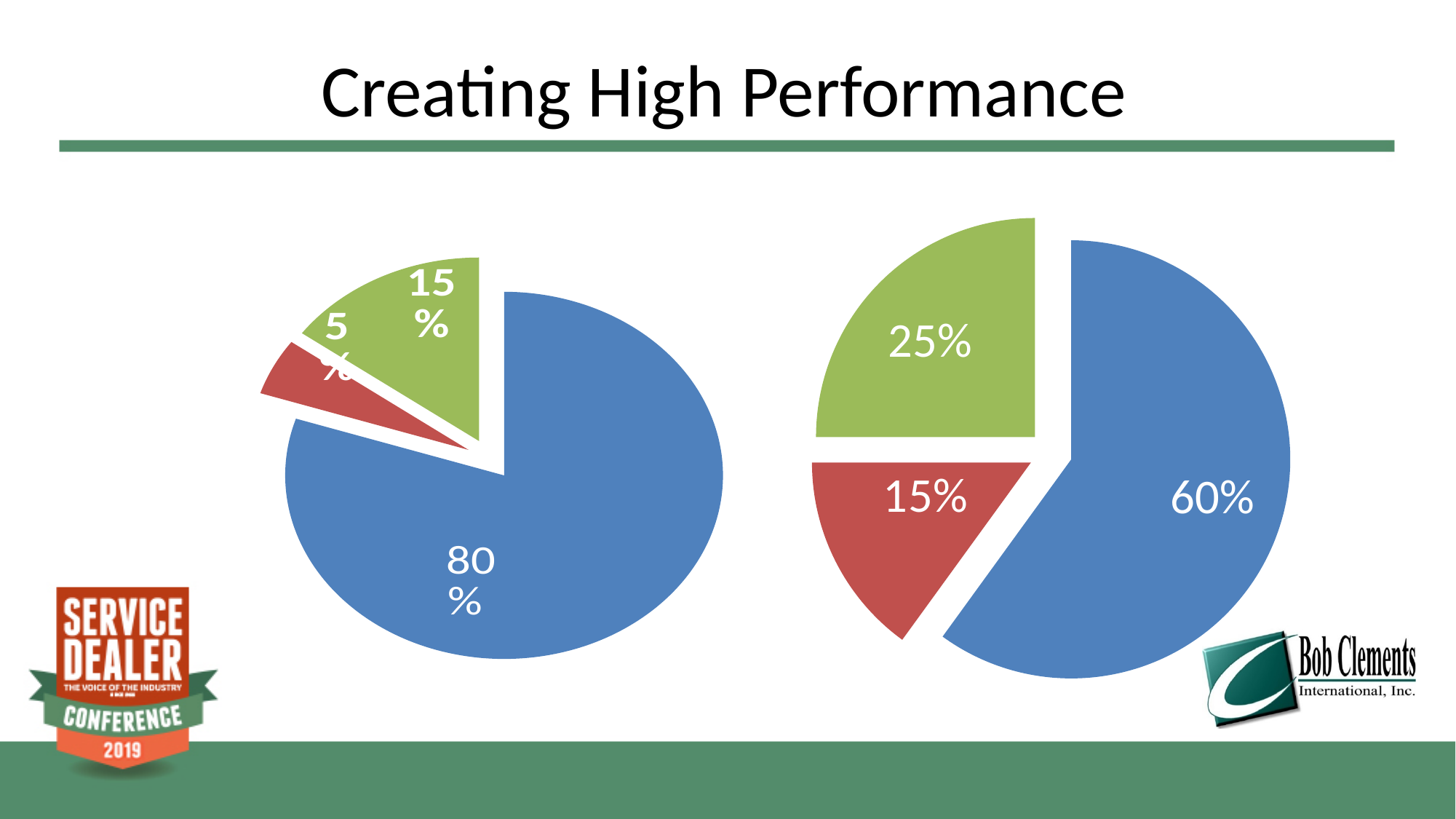
In the right pie chart, what share does the blue slice represent? 60% In the right pie chart, which colour slice is the largest? blue In the left pie chart, what share does the blue slice represent? 80% What kind of chart is the chart on the right side of the slide? pie chart What kind of chart is the chart on the left side of the slide? pie chart In the right pie chart, what share does the red slice represent? 15% How many slices does the left pie chart have? 3 How many slices does the right pie chart have? 3 In the right pie chart, which colour slice is the smallest? red In the right pie chart, what is the difference between the blue slice and the green slice? 35%